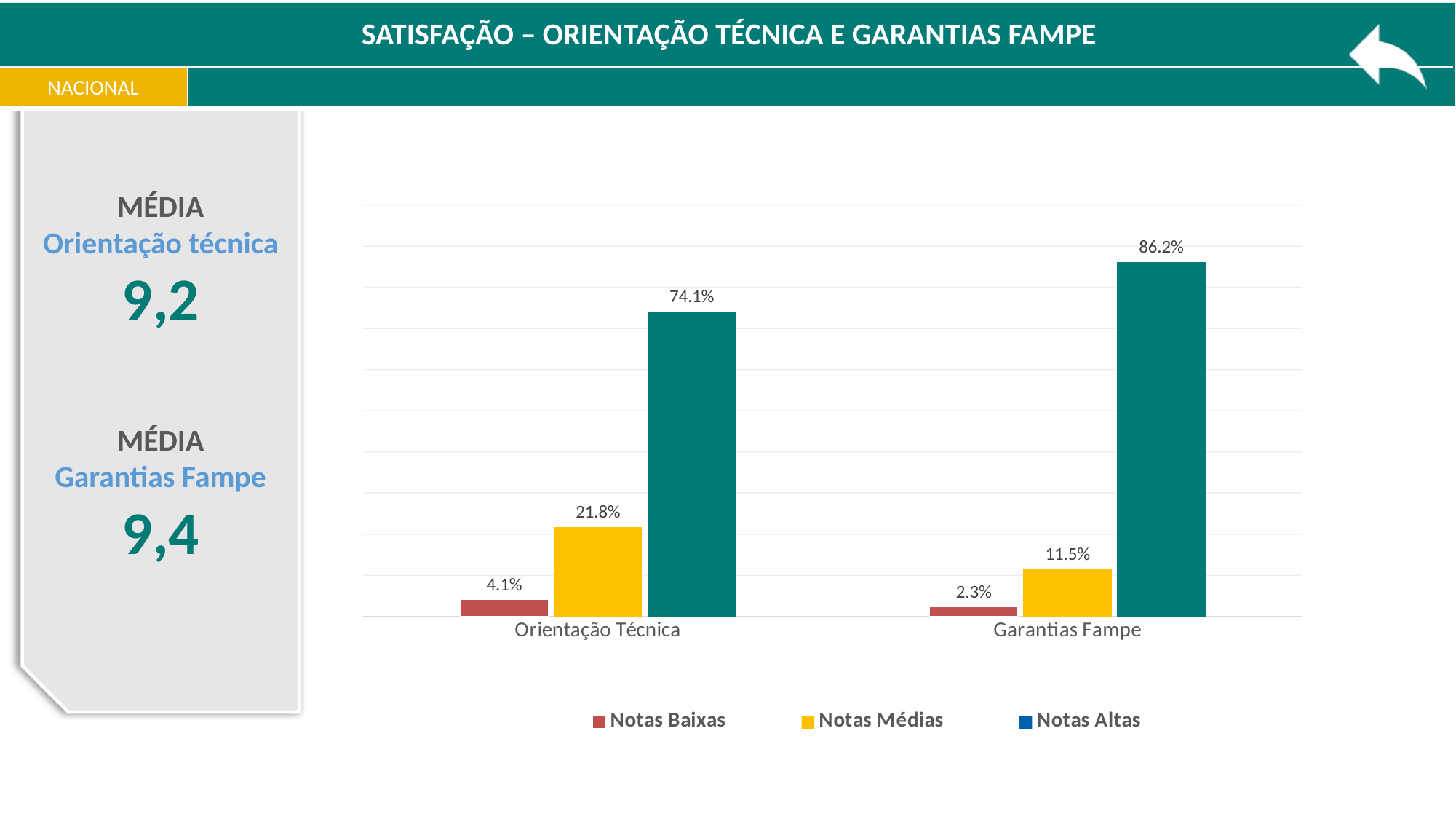
What is the value of Notas Baixas for Garantias Fampe? 2.3% What is the difference between the Notas Altas values for Garantias Fampe and Orientação Técnica? 12.1% Is the Notas Médias value larger for Orientação Técnica or for Garantias Fampe? Orientação Técnica Which series has the lowest value for Orientação Técnica? Notas Baixas What is the difference between the Notas Médias values for Orientação Técnica and Garantias Fampe? 10.3% What is the value of Notas Altas for Orientação Técnica? 74.1% What kind of chart is shown on the slide? Bar chart What is the value of Notas Médias for Orientação Técnica? 21.8% Which category has the higher Notas Altas value? Garantias Fampe How many series does the legend list? 3 What is the value of Notas Altas for Garantias Fampe? 86.2% How many categories are shown on the x axis? 2